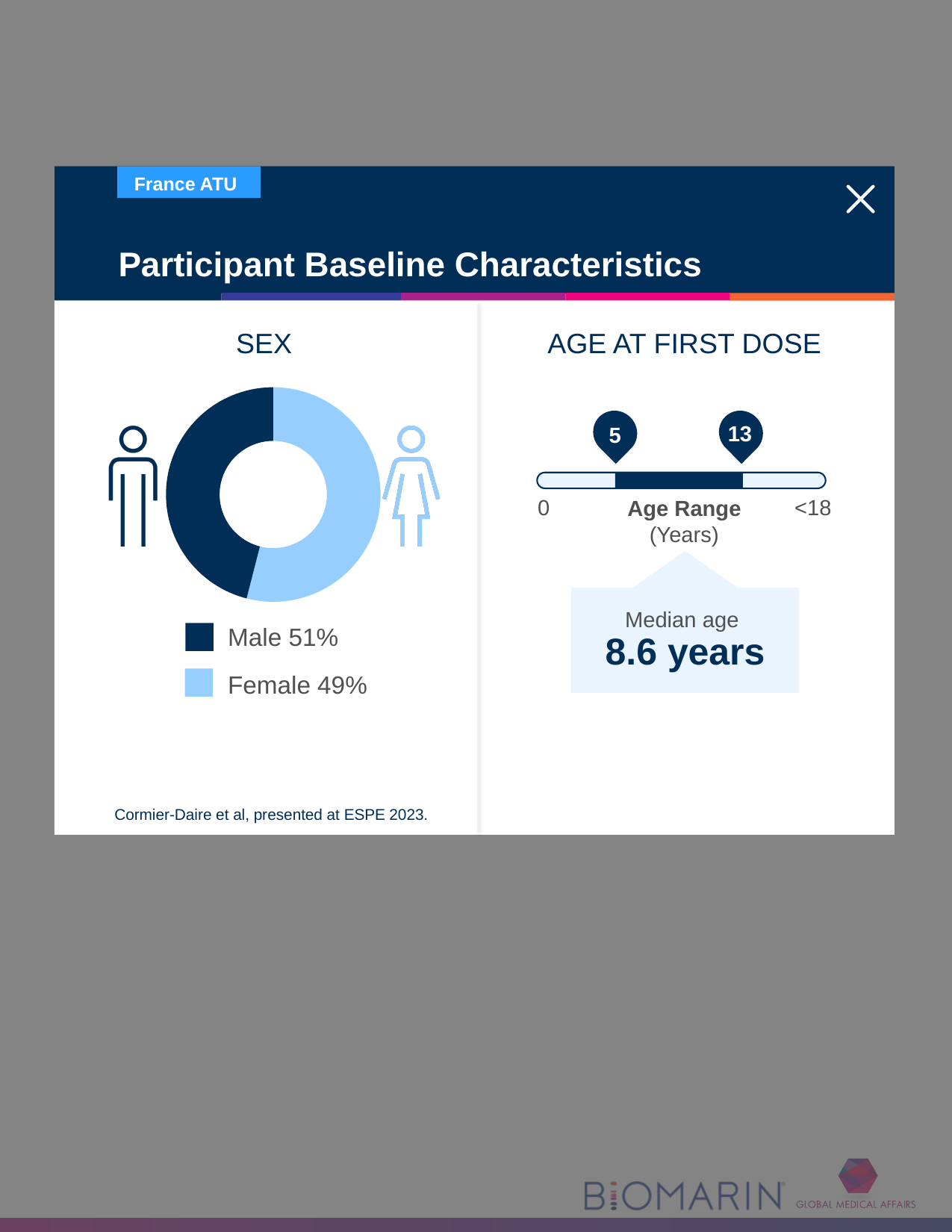
In the SEX chart, which category is shown in dark blue? Male In the AGE AT FIRST DOSE chart, what is the lower value marked on the age range bar? 5 What kind of chart is the SEX chart? Pie chart (donut) In the SEX chart, what percentage of participants are female? 49% In the AGE AT FIRST DOSE chart, what is the difference between the upper and lower marked age range values? 8 In the AGE AT FIRST DOSE chart, what are the two end labels of the age range axis? 0 and <18 In the AGE AT FIRST DOSE chart, what is the upper value marked on the age range bar? 13 In the AGE AT FIRST DOSE chart, what is the median age? 8.6 years In the SEX chart, which category has the larger share, Male or Female? Male In the SEX chart, what is the difference in percentage points between Male and Female? 2 In the SEX chart, what percentage of participants are male? 51% How many categories does the SEX chart show? 2